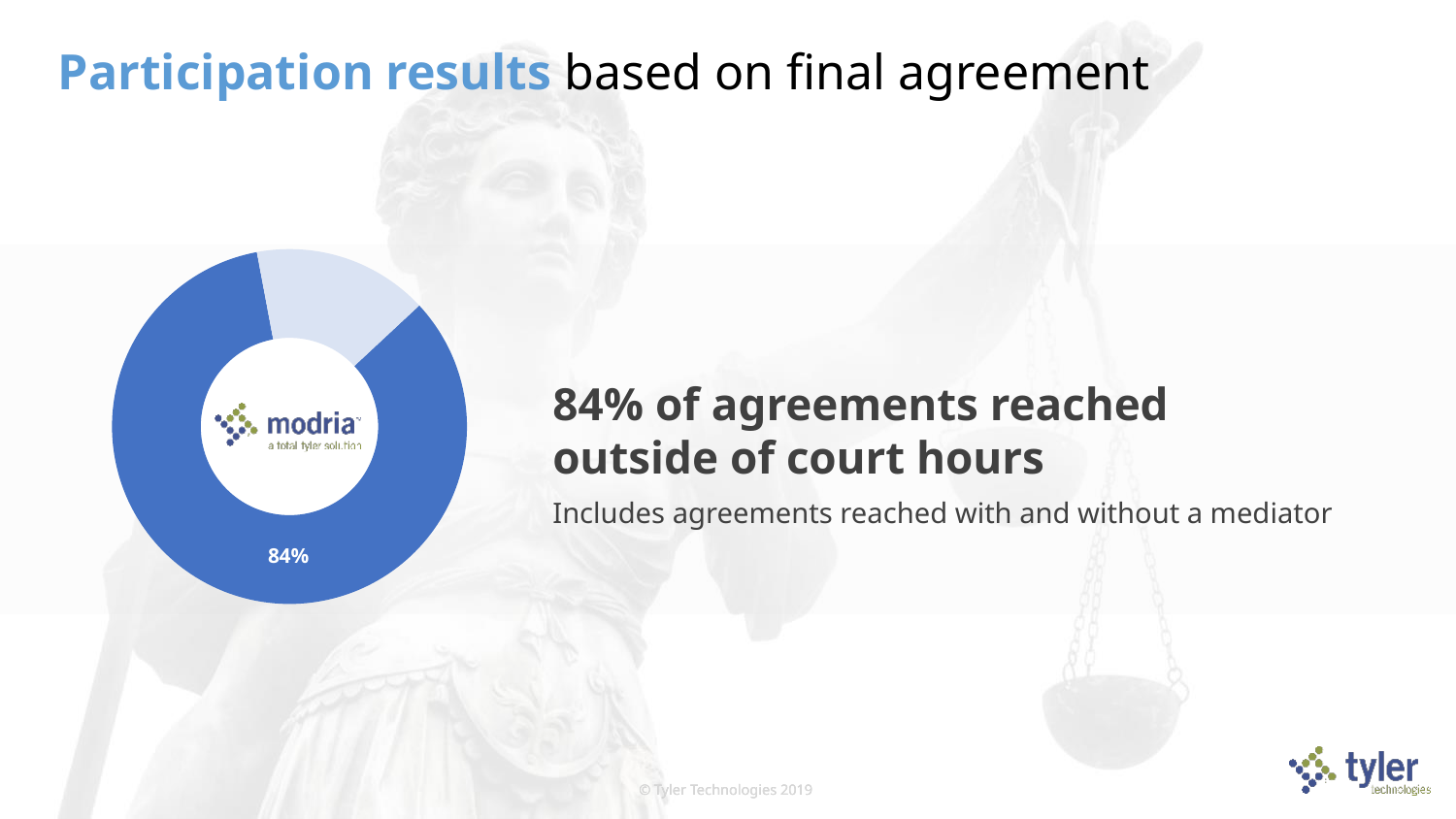
What logo appears in the centre of the donut chart? modria What share of the donut chart does the dark blue slice represent? 84% Is the dark blue slice of the donut chart greater or less than 50% of the whole? greater According to the slide text, what does the 84% in the chart represent? Agreements reached outside of court hours How many slices does the donut chart have? 2 Which slice of the donut chart is larger, the dark blue one or the light blue one? The dark blue one What kind of chart is shown on the slide? Donut (pie) chart What value is printed on the large dark blue slice of the donut chart? 84%